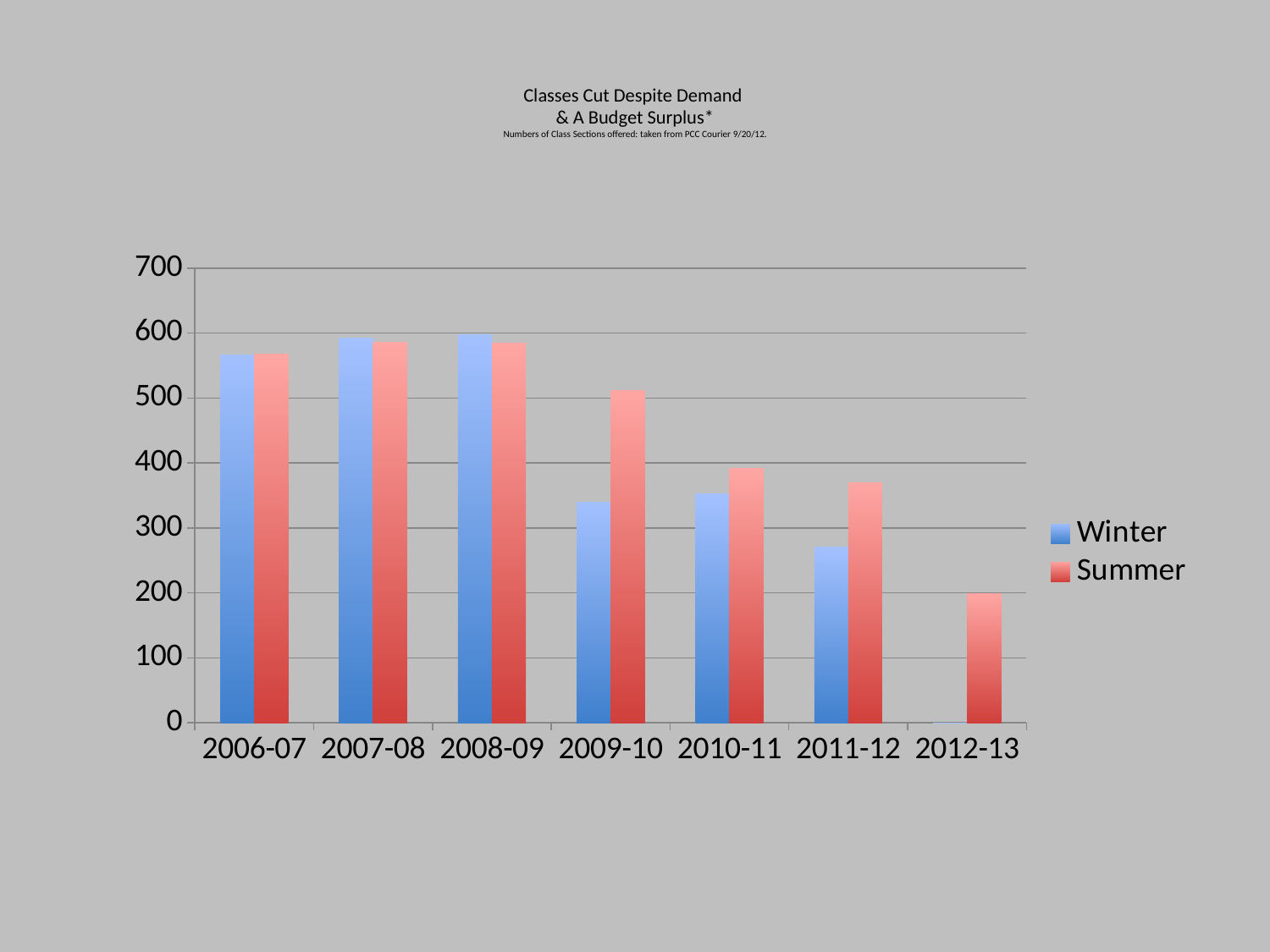
Which year has the lowest Summer value? 2012-13 Which series is shown in red? Summer Do the Summer values generally rise or fall from 2008-09 to 2012-13? fall Is the Winter value for 2011-12 greater or less than 300? less How many series does the legend list? 2 Is the Winter value for 2006-07 greater or less than 500? greater What kind of chart is shown on the slide? bar chart Which year has the lowest Winter value? 2012-13 Is the Winter value for 2009-10 greater or less than 400? less In 2009-10, which is larger, the Winter value or the Summer value? Summer How many academic years are shown on the x axis? 7